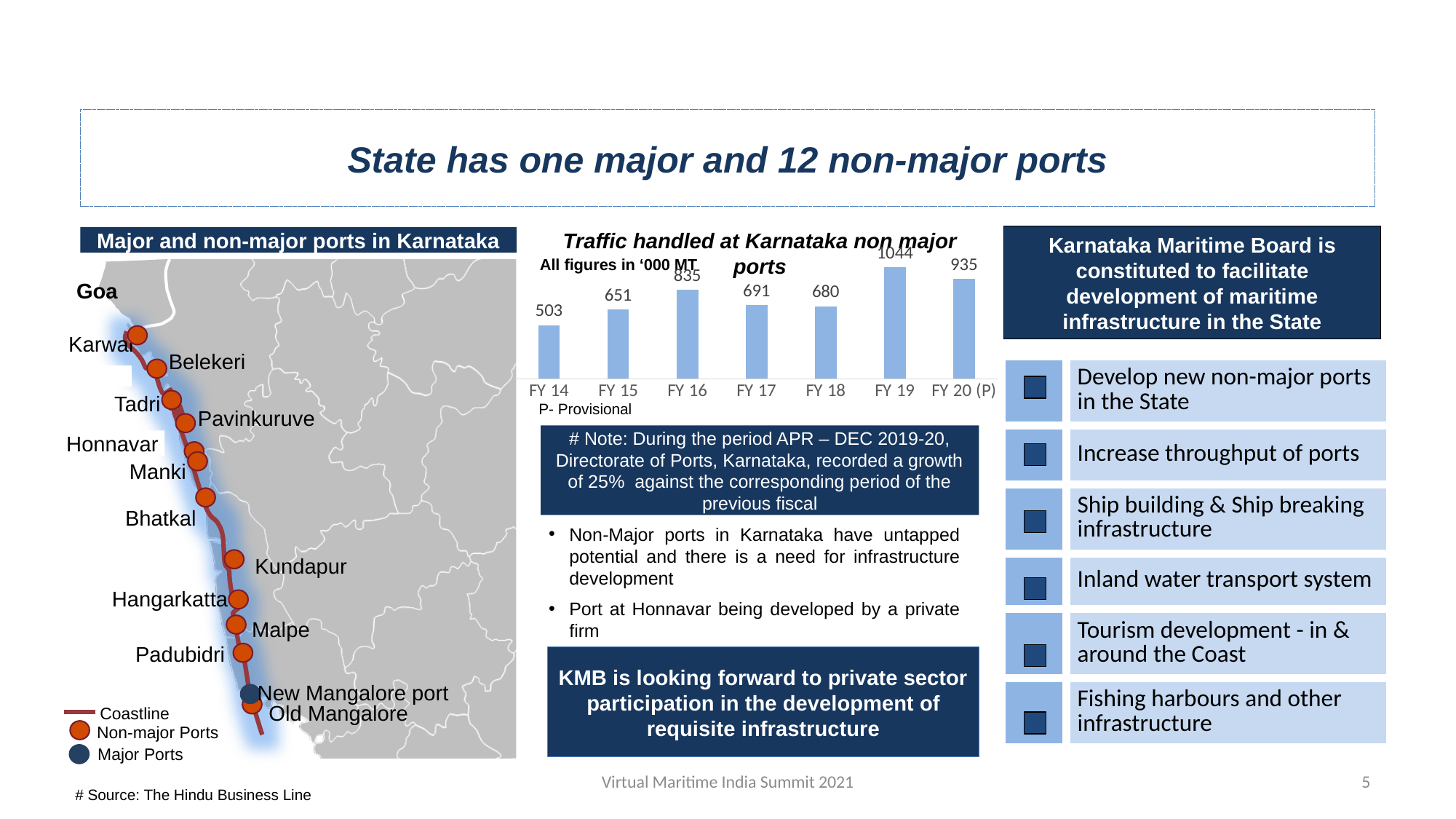
What is the traffic handled at Karnataka non-major ports in FY 14? 503 What is the traffic handled at Karnataka non-major ports in FY 20 (P)? 935 Which fiscal year has the highest traffic handled at Karnataka non-major ports? FY 19 What is the difference in traffic handled at Karnataka non-major ports between FY 15 and FY 14? 148 Which fiscal year has the lowest traffic handled at Karnataka non-major ports? FY 14 What type of chart is used to show traffic handled at Karnataka non-major ports? Bar chart What is the difference in traffic handled at Karnataka non-major ports between FY 19 and FY 20 (P)? 109 Did traffic handled at Karnataka non-major ports rise or fall from FY 14 to FY 16? Rise What is the traffic handled at Karnataka non-major ports in FY 16? 835 How many fiscal years are shown in the traffic handled at Karnataka non-major ports chart? 7 In what unit are the figures in the traffic handled at Karnataka non-major ports chart expressed? '000 MT Which year had higher traffic at Karnataka non-major ports, FY 16 or FY 17? FY 16